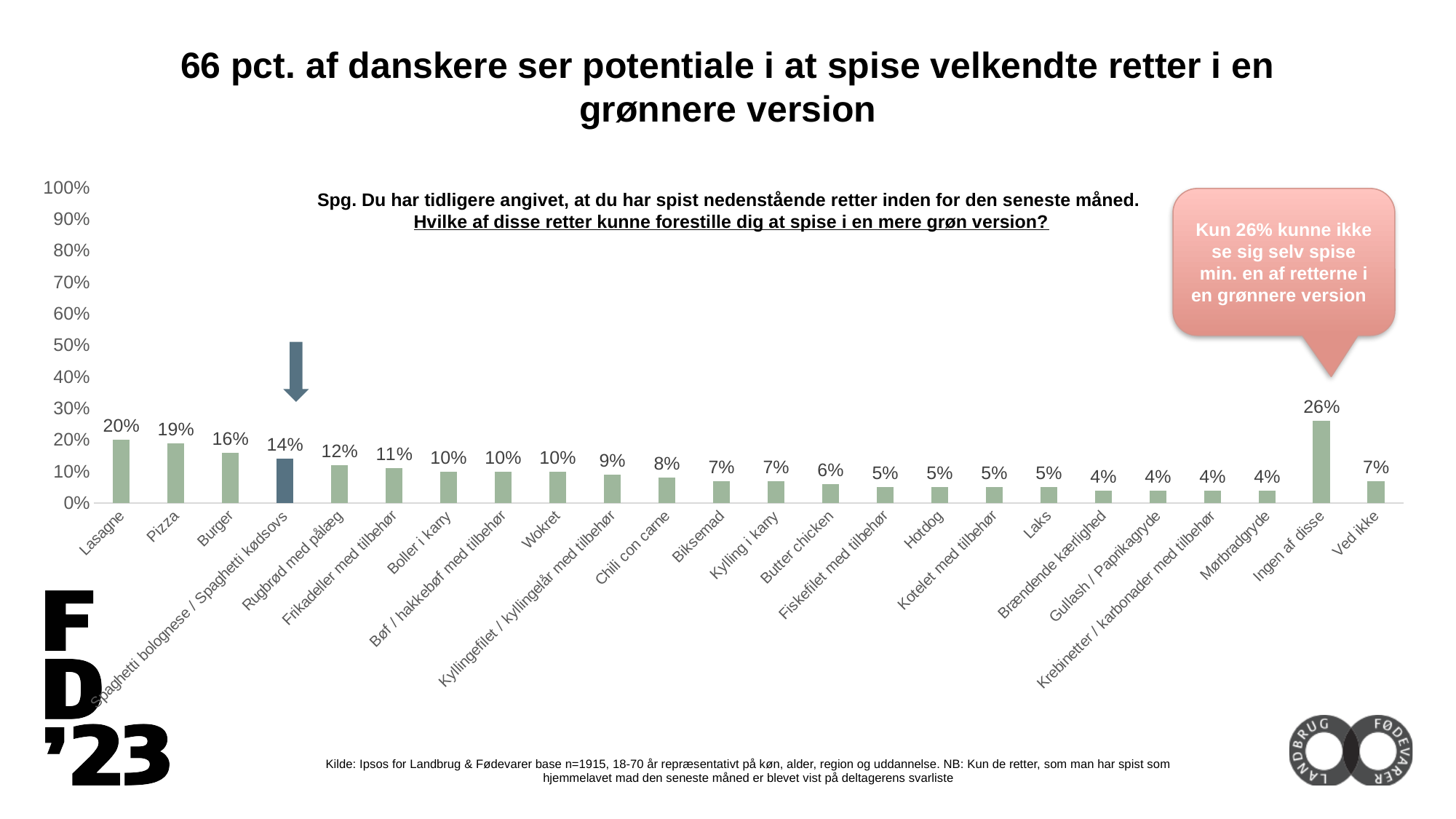
Which is larger, the value for Rugbrød med pålæg or the value for Chili con carne? Rugbrød med pålæg How many categories are shown on the x axis? 24 Which category has the highest value? Ingen af disse What is the difference between the values for Ingen af disse and Pizza? 7% Is the value for Ingen af disse greater or less than 20%? greater What is the value for Butter chicken? 6% What is the value for Spaghetti bolognese / Spaghetti kødsovs? 14% What kind of chart is shown on the slide? bar chart What is the value for Ved ikke? 7% Which bar is shown in a darker colour than the others? Spaghetti bolognese / Spaghetti kødsovs What is the value for Lasagne? 20% What is the difference between the values for Lasagne and Burger? 4%